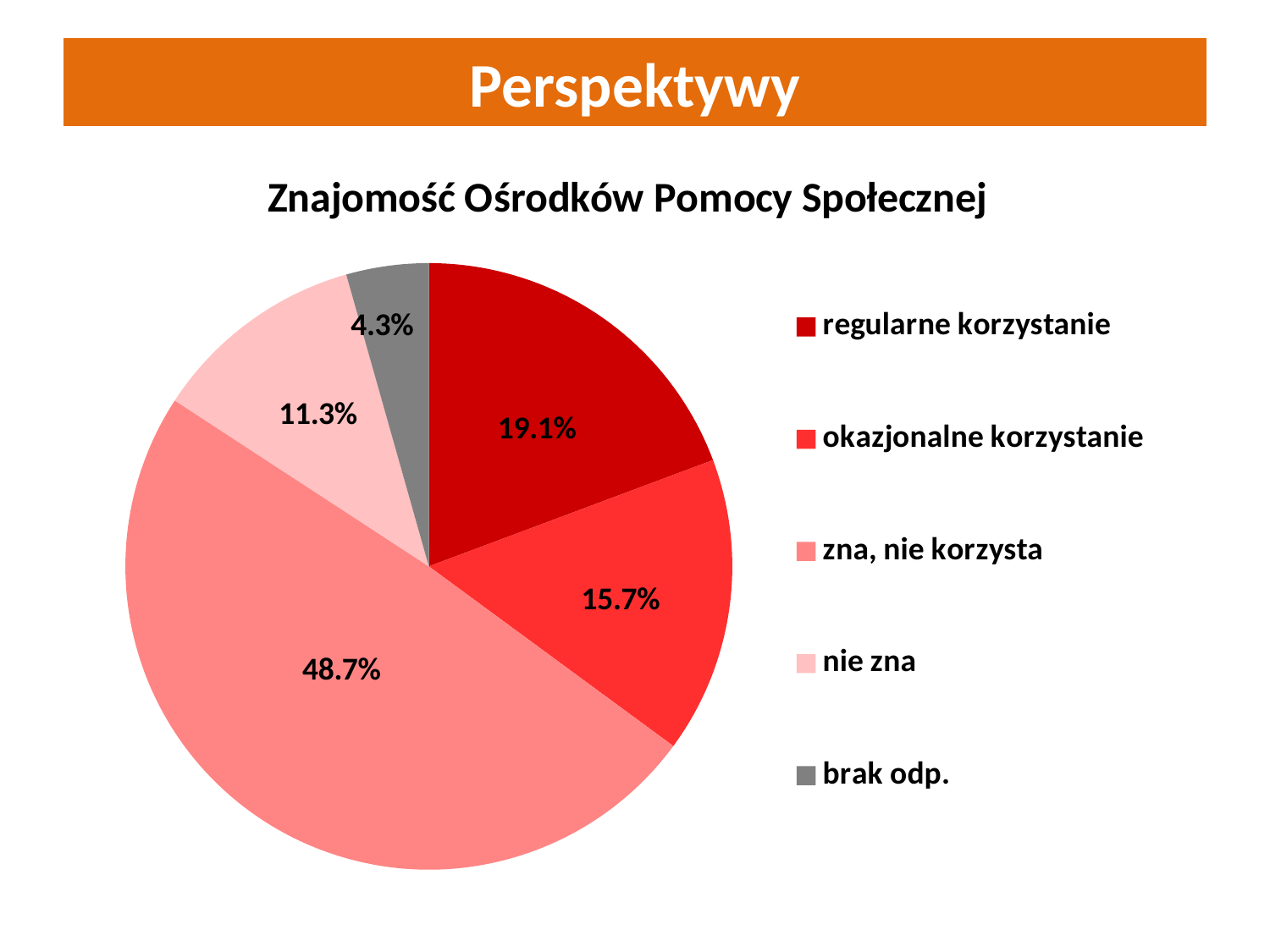
What is the difference between the values for "regularne korzystanie" and "okazjonalne korzystanie"? 3.4% How many categories does the pie chart show? 5 What is the value for "brak odp."? 4.3% What is the title of the chart? Znajomość Ośrodków Pomocy Społecznej What kind of chart is shown on the slide? pie chart What is the value for "regularne korzystanie"? 19.1% What is the value for "nie zna"? 11.3% What share of the pie does "zna, nie korzysta" represent? 48.7% Which category has the smallest slice of the pie? brak odp. Which is larger, the value for "nie zna" or the value for "okazjonalne korzystanie"? okazjonalne korzystanie What is the value for "okazjonalne korzystanie"? 15.7% Which category has the largest slice of the pie? zna, nie korzysta